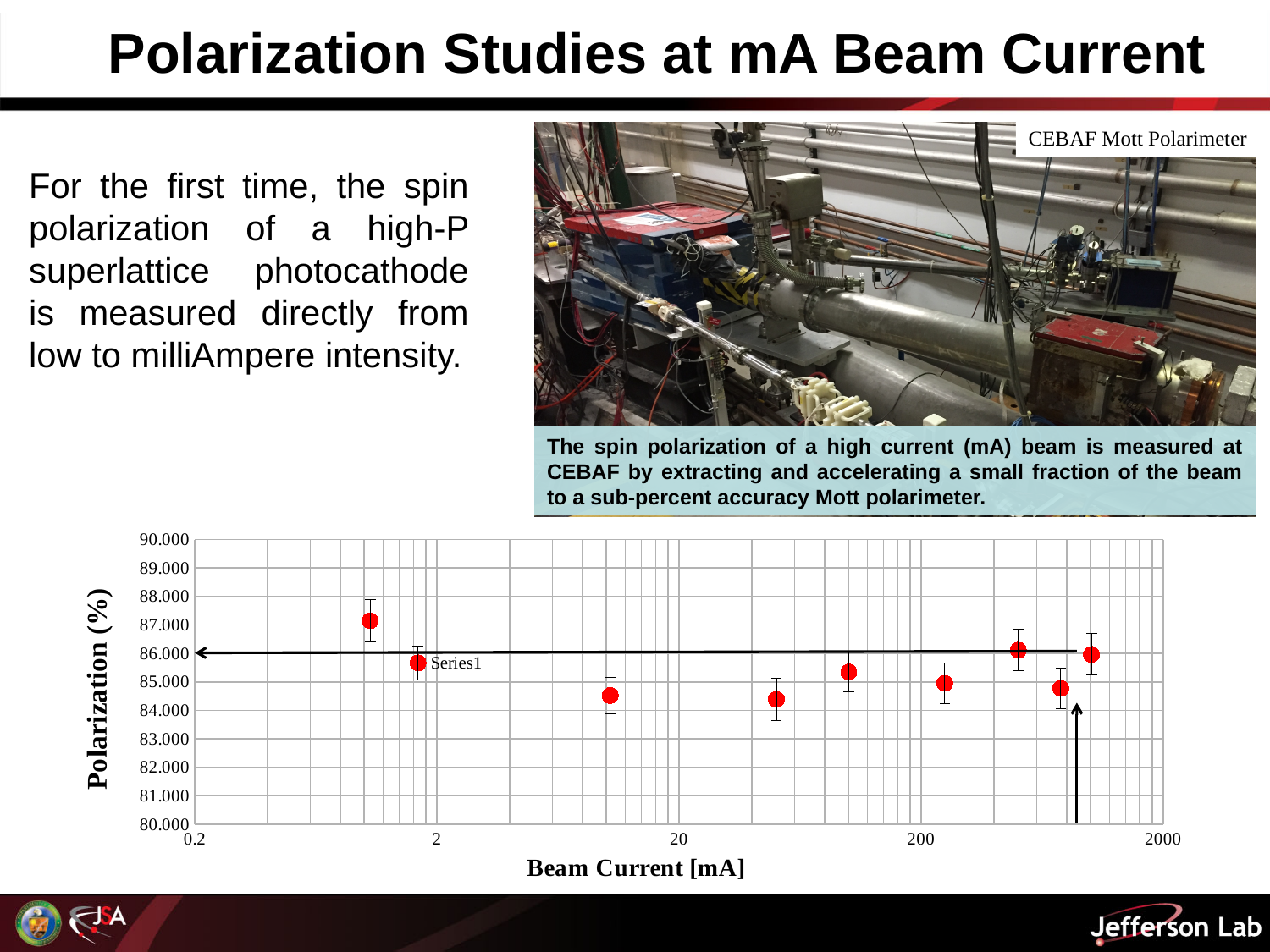
What is the title of the y axis of the chart? Polarization (%) Which data point has the highest polarization value? the leftmost point Is the polarization value for the data point near 10 mA greater or less than 85.000? less What is the title of the x axis of the chart? Beam Current [mA] Which has the larger polarization value: the leftmost data point (near 1 mA) or the data point near 10 mA? the leftmost point (near 1 mA) Is the polarization value for the data point near 500 mA greater or less than 85.000? greater What kind of chart is shown at the bottom of the slide? scatter chart Is the polarization value for the leftmost data point (near 1 mA) greater or less than 86.000? greater Which has the larger polarization value: the data point near 500 mA or the data point near 800 mA? the point near 500 mA How many data points are plotted in the chart? 9